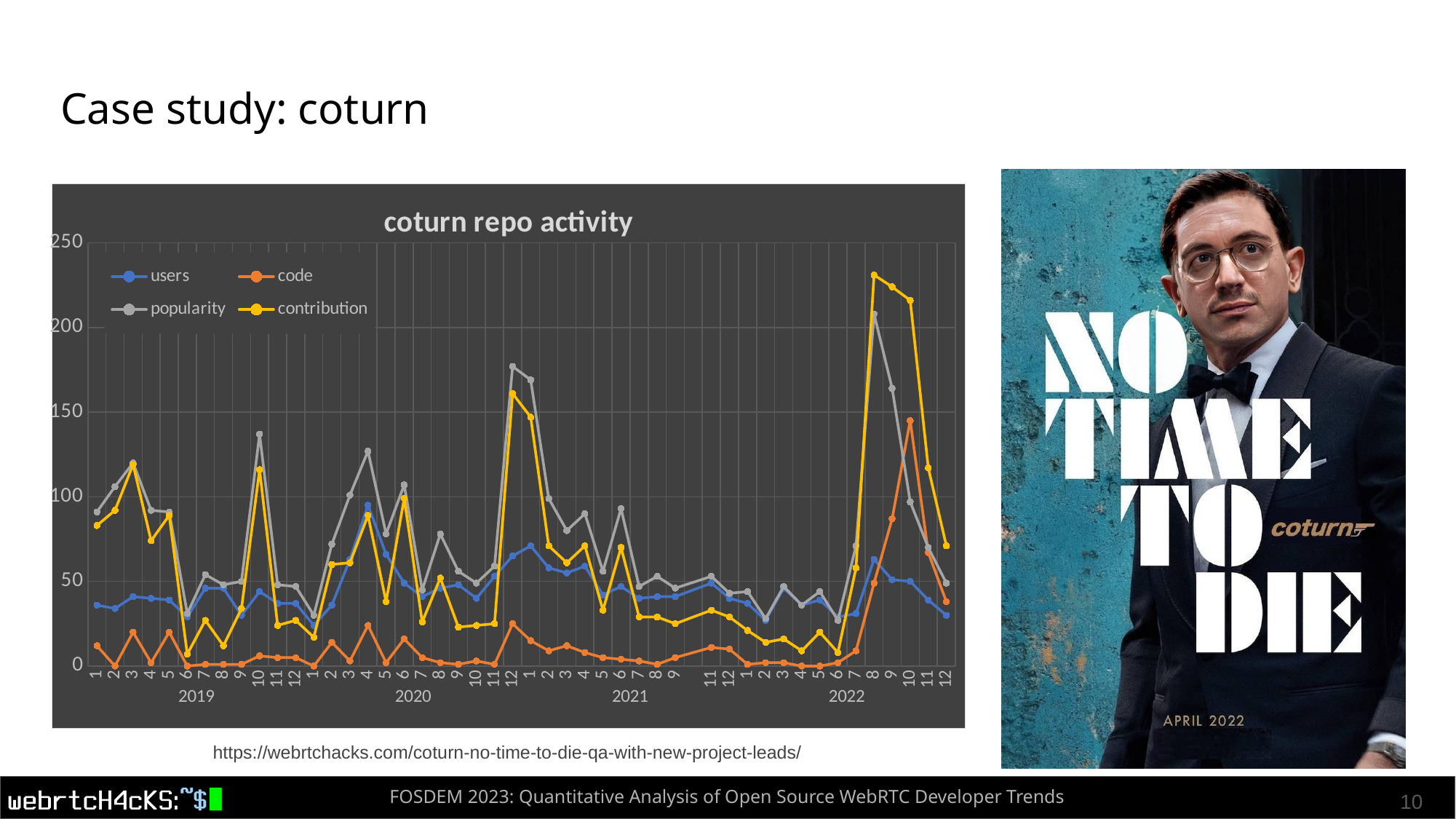
Is the value for users in month 1 of 2019 greater or less than 50? less Is the value for contribution in month 8 of 2022 greater or less than 200? greater How many series does the chart's legend list? 4 In month 10 of 2022, which is larger, the value for code or the value for users? code Which series stays lowest across most of the chart? code What is the title of the chart? coturn repo activity How many years are labelled along the x axis of the chart? 4 Which series is drawn in orange in the chart? code Is the value for code in month 10 of 2022 greater or less than 100? greater What kind of chart is shown on the slide? line chart Which series reaches the highest value anywhere on the chart? contribution In month 12 of 2020, which is larger, the value for popularity or the value for code? popularity